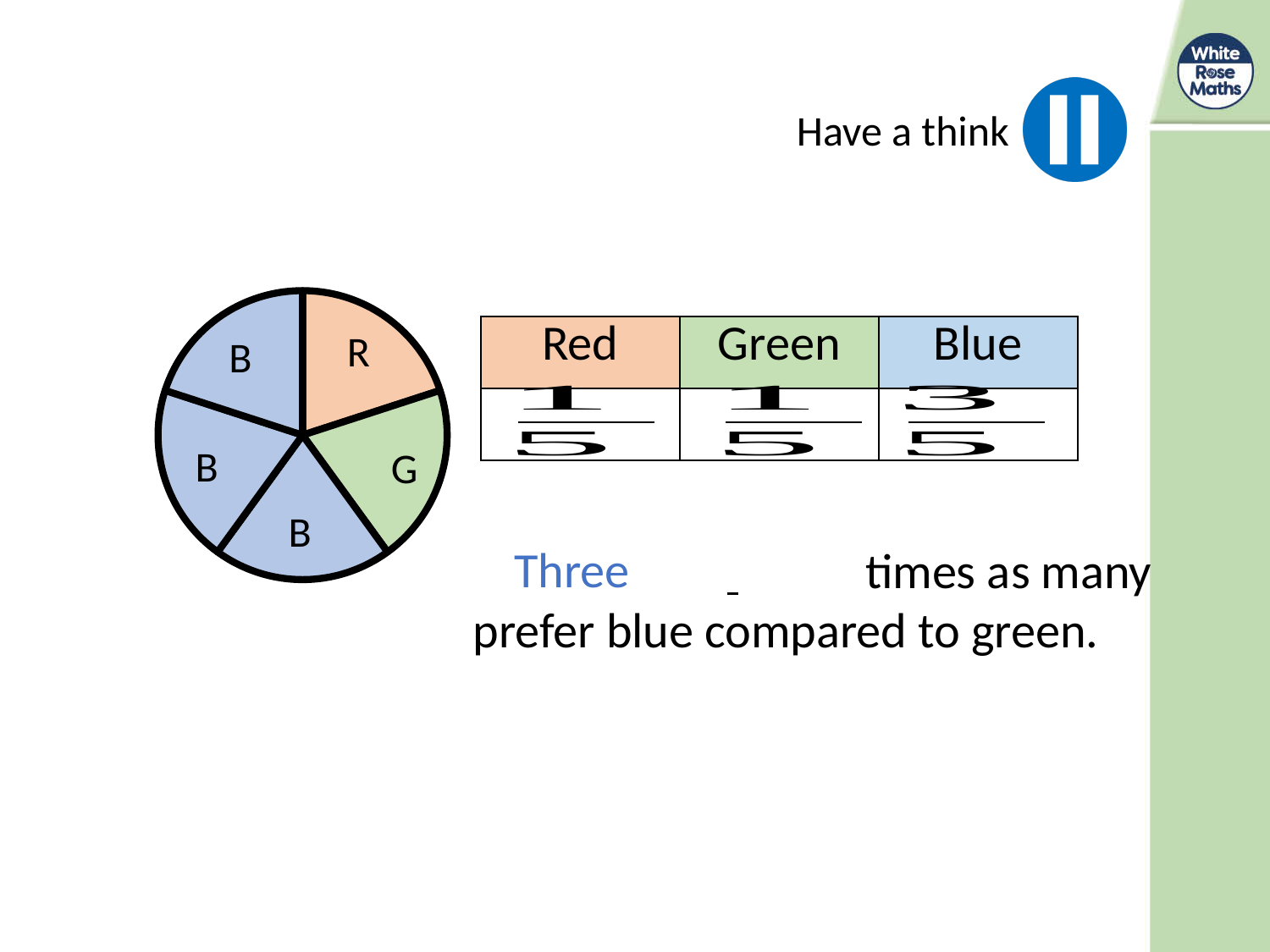
According to the table, what fraction prefer blue? 3/5 How many slices of the pie chart are labelled B? 3 According to the table, what fraction prefer red? 1/5 How many slices does the pie chart have? 5 How many colour categories does the table list? 3 Which is larger, the share for blue or the share for green? blue What kind of chart is shown on the slide? pie chart What letter labels the orange slice of the pie chart? R Which colour has the largest share of the pie chart? Blue How many times as many prefer blue compared to green, according to the slide? Three According to the table, what fraction prefer green? 1/5